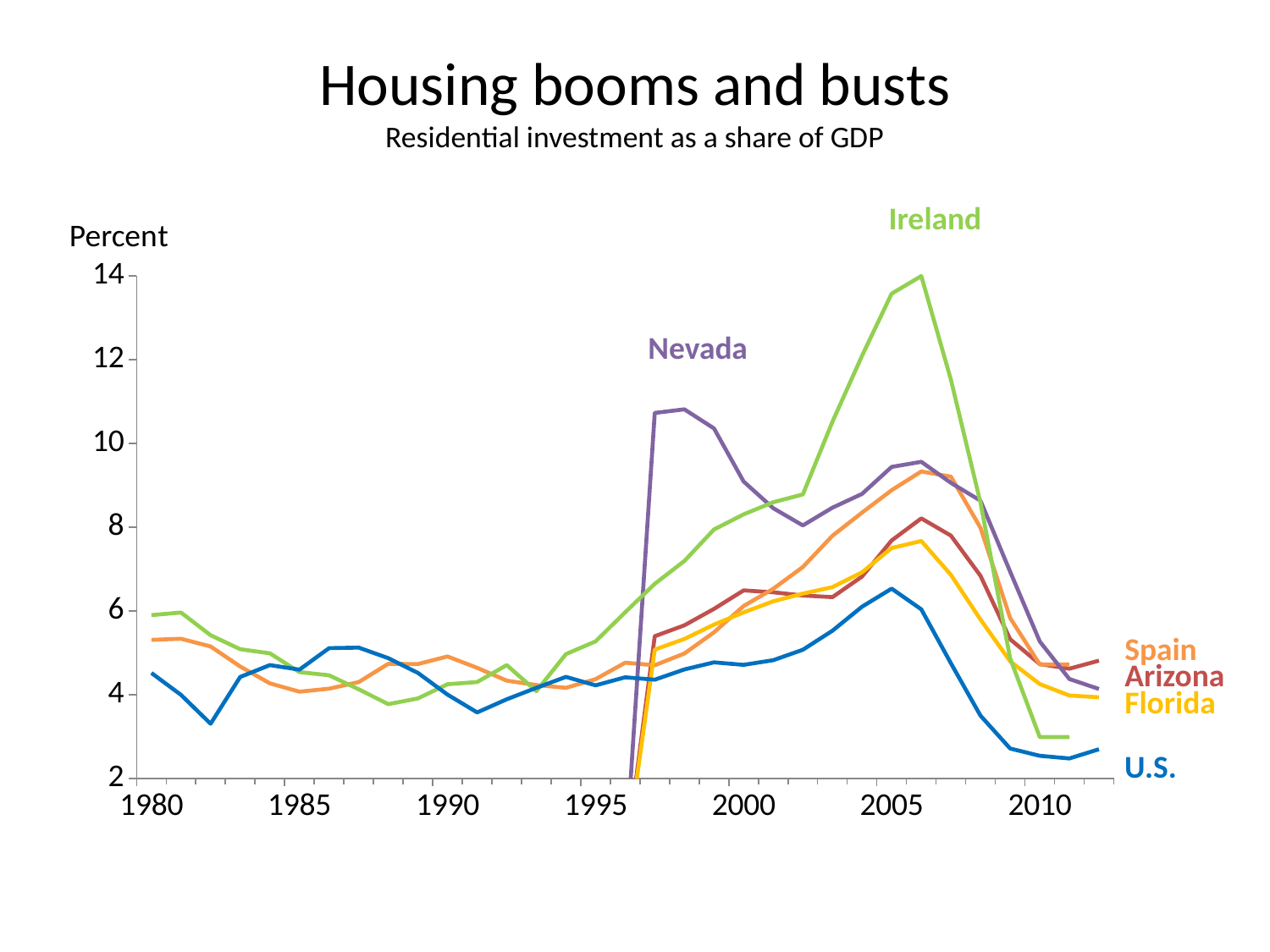
How many series are plotted on the chart? 6 Is the value for Florida in 2006 greater or less than 6? greater Is the value for the U.S. in 2010 greater or less than 4? less Does the value for Ireland rise or fall between 2006 and 2010? fall Is the value for Spain in 2006 greater or less than 8? greater In 2006, which is larger: the value for Ireland or the value for the U.S.? Ireland What kind of chart is shown on the slide? line chart Which series reaches the highest peak on the chart? Ireland What is the subtitle of the chart? Residential investment as a share of GDP Which series has the lowest value in 2009? U.S.